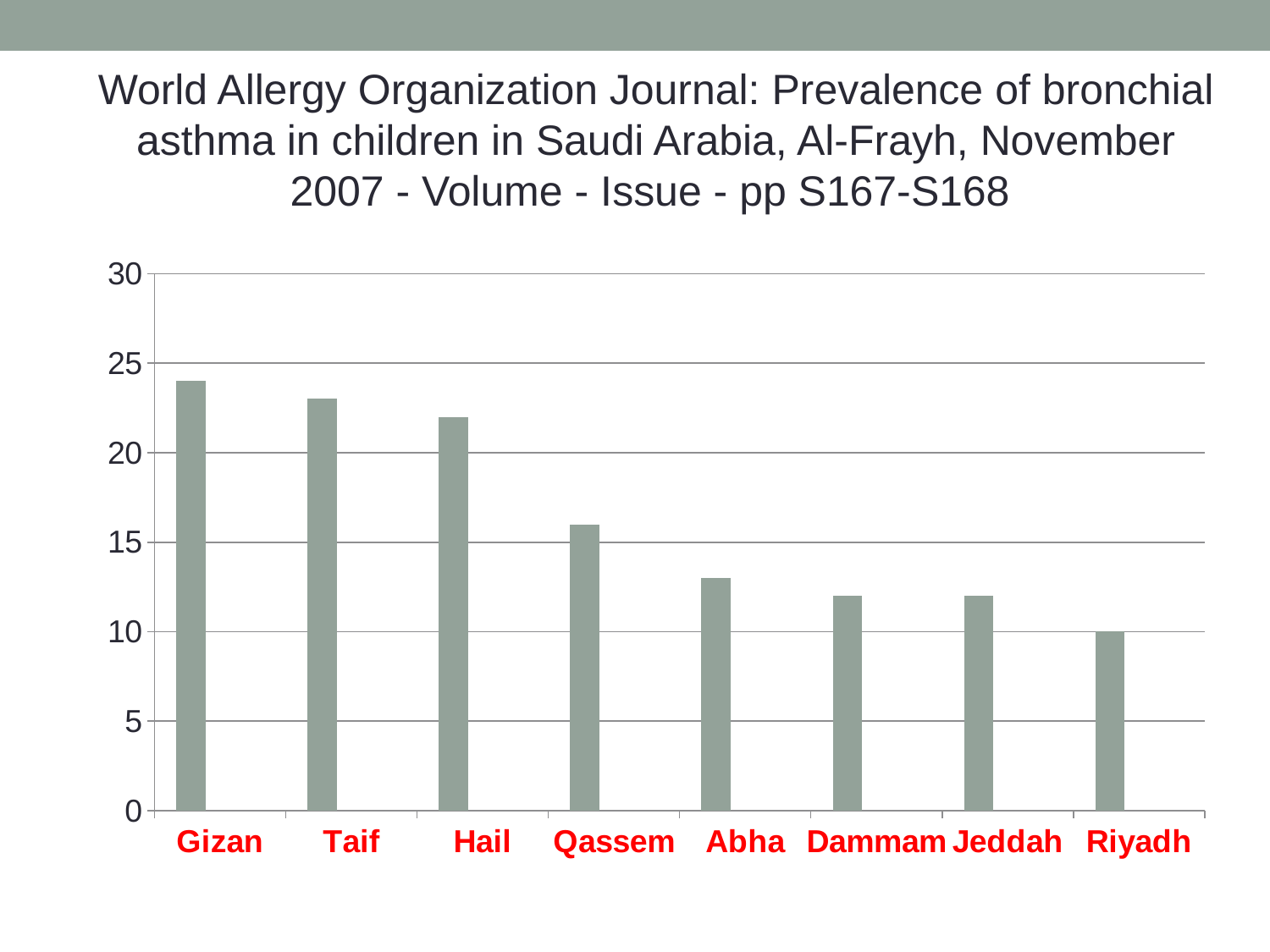
Which city has the lowest bar in the chart? Riyadh Do the bar values rise or fall from left to right along the x axis? fall Is the value for Abha greater or less than 15? less How many cities are shown on the x axis of the chart? 8 Which city has the highest bar in the chart? Gizan What colour are the city labels on the x axis? red Is the value for Qassem greater or less than 15? greater Is the value for Hail greater or less than 25? less What kind of chart is shown on the slide? bar chart Which is larger, the value for Taif or the value for Qassem? Taif